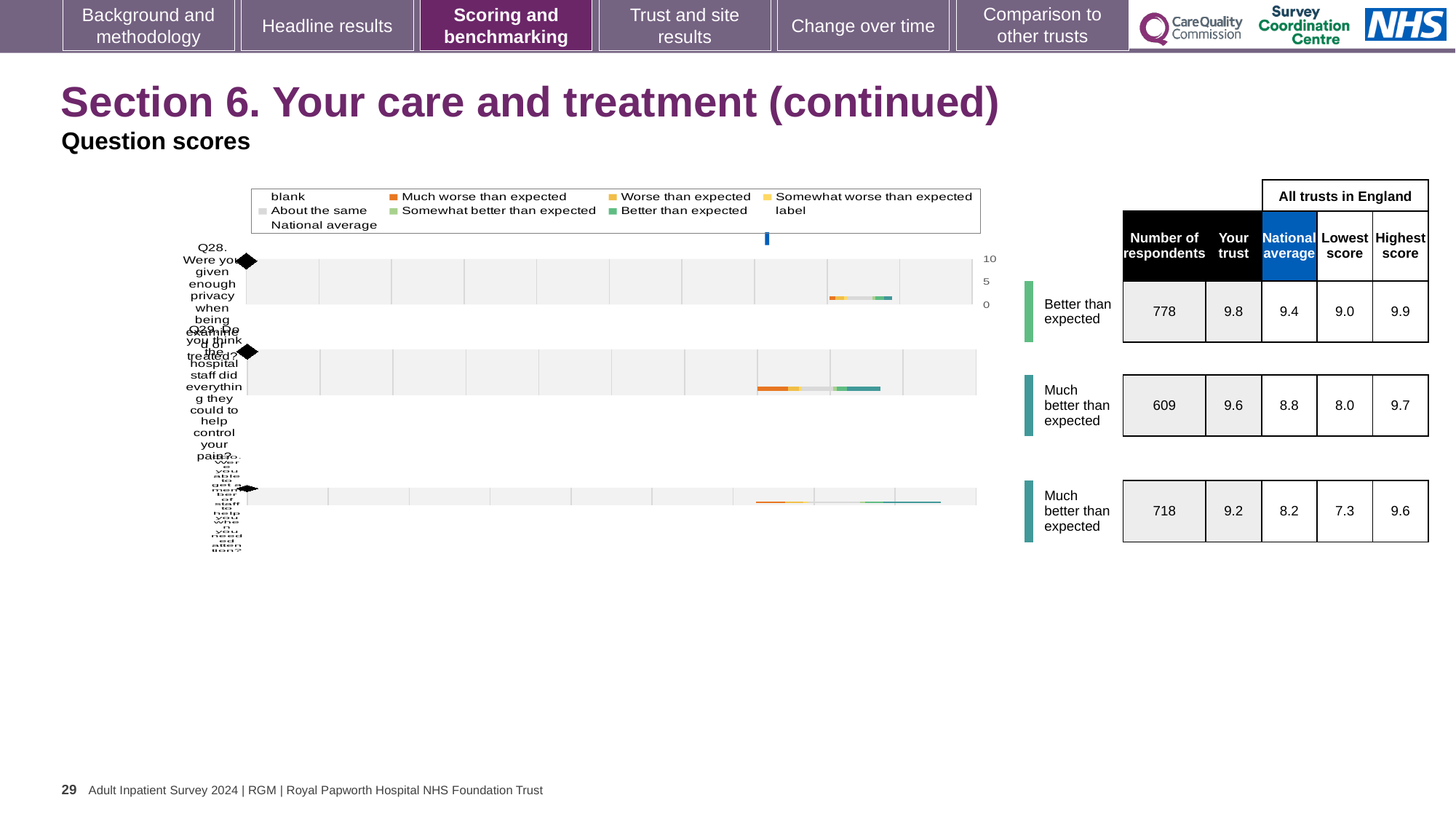
What kind of chart is shown on the slide? Bar chart How many respondents answered Q30 (able to get a member of staff to help when needed)? 718 What benchmark category is shown for Q30? Much better than expected How many survey questions (rows) does the chart show? 3 What is the national average score for Q29 (hospital staff helping control pain)? 8.8 What benchmark category is shown for Q28? Better than expected Which question has the highest 'Your trust' score? Q28 Which question has the lowest 'Lowest score' across all trusts in England? Q30 What is the 'Your trust' score for Q28 (privacy when being examined or treated)? 9.8 What is the highest score across all trusts in England for Q29? 9.7 What is the difference between the 'Your trust' score and the national average for Q28? 0.4 Which has the higher 'Your trust' score, Q29 or Q30? Q29